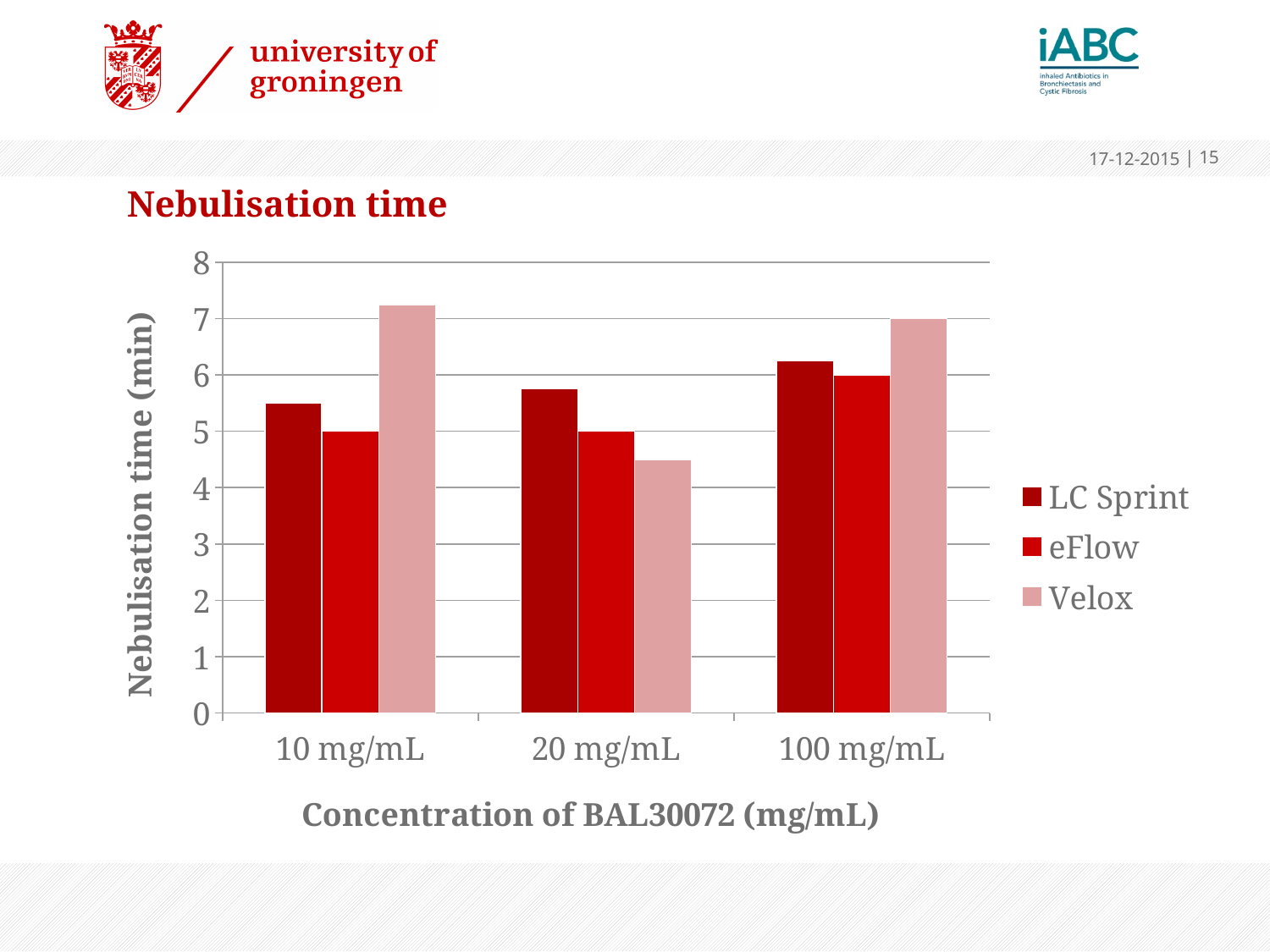
What is the nebulisation time for eFlow at 10 mg/mL? 5 Does the nebulisation time for LC Sprint rise or fall as the concentration increases from 10 mg/mL to 100 mg/mL? rise How many series does the legend list? 3 What is the nebulisation time for eFlow at 20 mg/mL? 5 Which nebuliser has the lowest nebulisation time at 20 mg/mL? Velox Is the nebulisation time for Velox at 10 mg/mL greater or less than 7? greater Is the nebulisation time for LC Sprint at 100 mg/mL greater or less than 6? greater What kind of chart is shown on the slide? bar chart Which nebuliser has the highest nebulisation time at 10 mg/mL? Velox How many concentration categories are shown on the x axis? 3 What is the title of the y axis? Nebulisation time (min) Is the nebulisation time for Velox at 20 mg/mL greater or less than 5? less